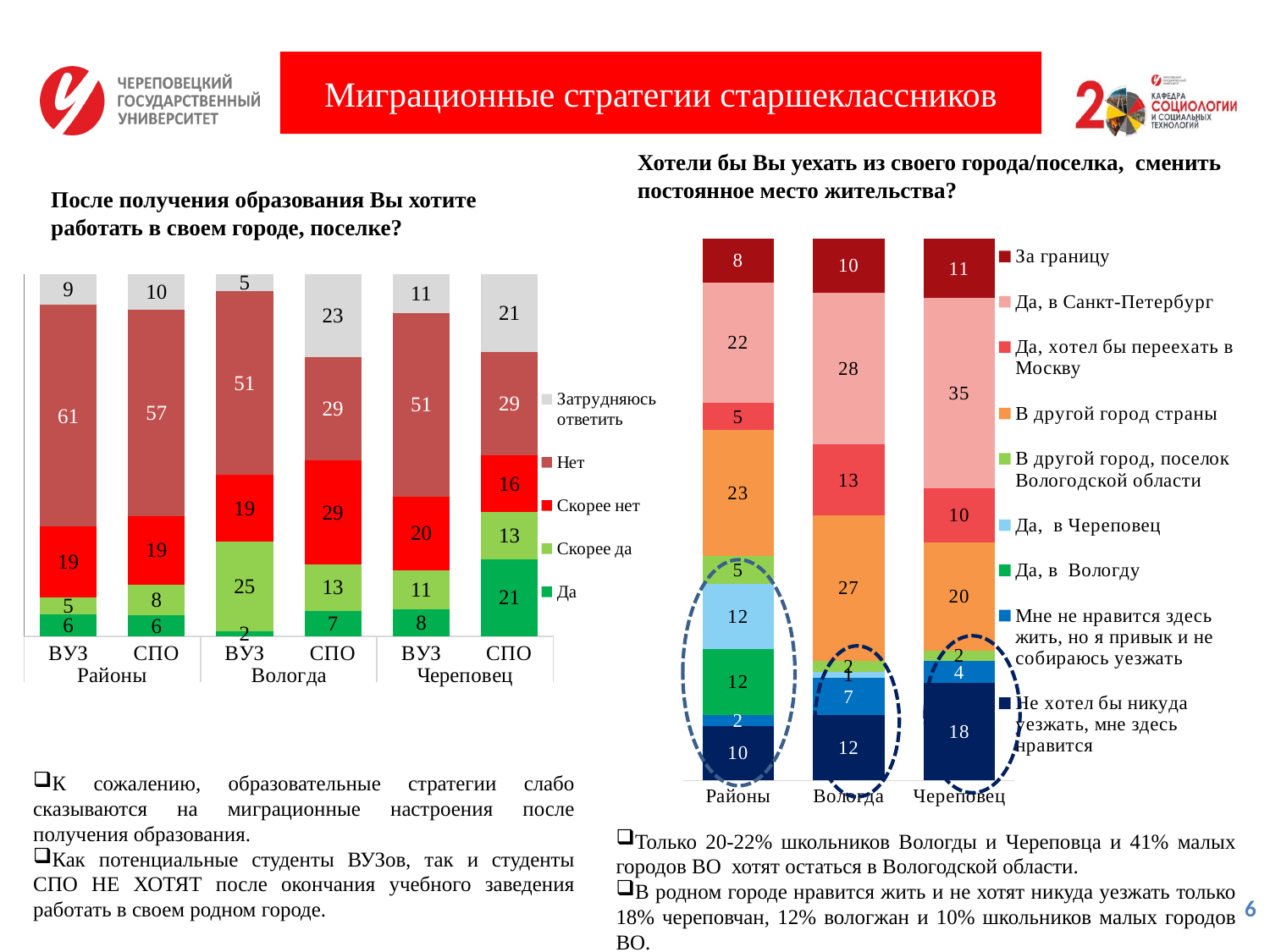
In the left chart (После получения образования Вы хотите работать в своем городе, поселке?), how many bars are plotted? 6 In the left chart (После получения образования Вы хотите работать в своем городе, поселке?), what is the value of "Да" for СПО in Череповец? 21 In the right chart (Хотели бы Вы уехать из своего города/поселка?), what is the value of "Да, в Санкт-Петербург" for Череповец? 35 In the right chart (Хотели бы Вы уехать из своего города/поселка?), how many series does the legend list? 9 In the left chart (После получения образования Вы хотите работать в своем городе, поселке?), how many series does the legend list? 5 In the left chart (После получения образования Вы хотите работать в своем городе, поселке?), what is the value of "Нет" for ВУЗ in Районы? 61 What type of chart is the right chart (Хотели бы Вы уехать из своего города/поселка?)? Stacked bar chart In the left chart (После получения образования Вы хотите работать в своем городе, поселке?), what is the difference between "Скорее да" for ВУЗ in Вологда and "Скорее да" for ВУЗ in Череповец? 14 In the left chart (После получения образования Вы хотите работать в своем городе, поселке?), which bar has the highest value for "Нет"? ВУЗ Районы In the right chart (Хотели бы Вы уехать из своего города/поселка?), is the value of "В другой город страны" larger for Районы or for Череповец? Районы In the right chart (Хотели бы Вы уехать из своего города/поселка?), what is the value of "Не хотел бы никуда уезжать, мне здесь нравится" for Районы? 10 In the right chart (Хотели бы Вы уехать из своего города/поселка?), which category has the lowest value for "За границу"? Районы